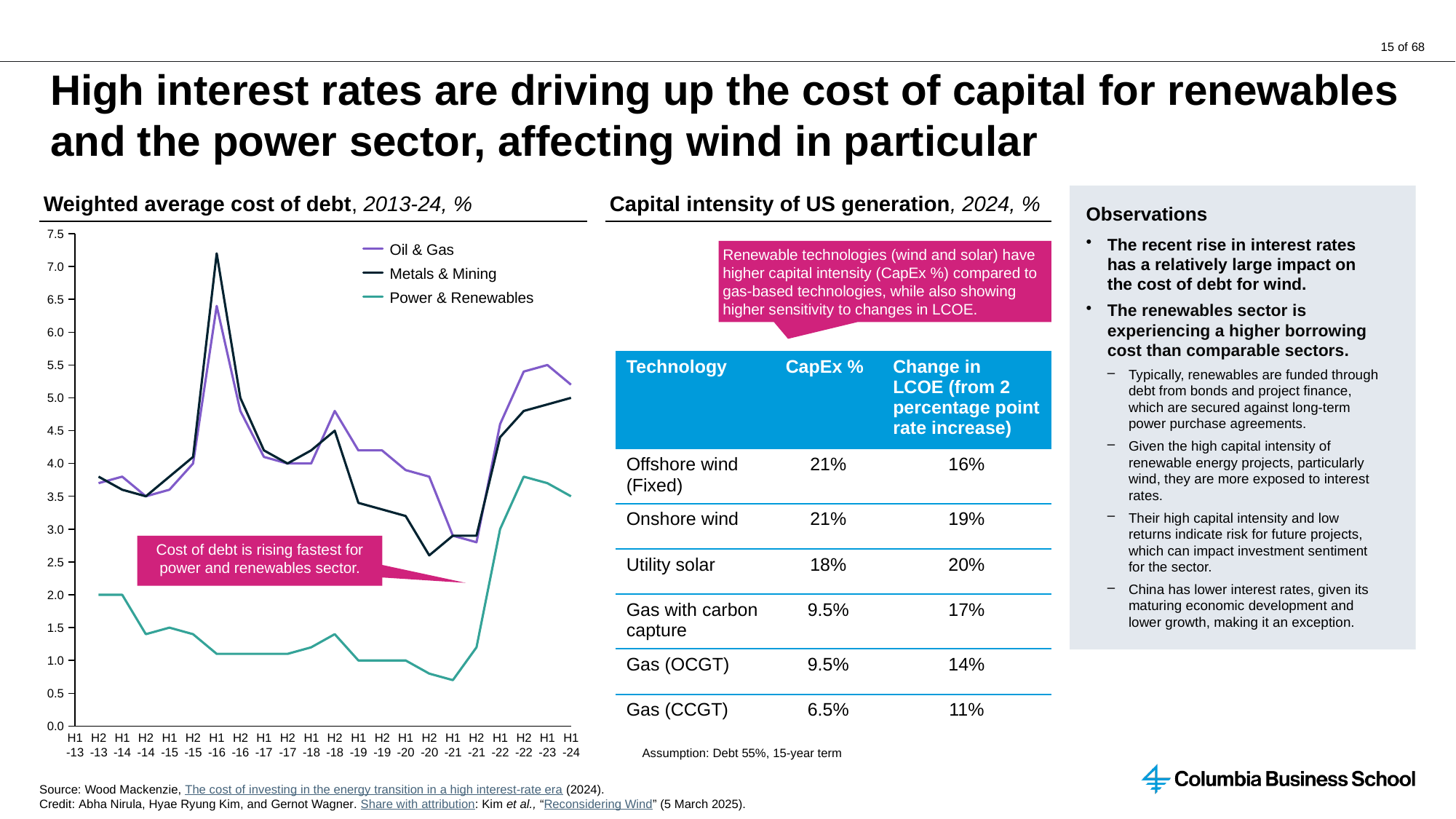
How many half-year periods are shown on the x axis of the 'Weighted average cost of debt' chart? 22 In the 'Weighted average cost of debt' chart, is the value for Power & Renewables at H2-16 greater or less than 1.5? less In the 'Weighted average cost of debt' chart, which series reaches the highest peak over the whole period? Metals & Mining What kind of chart is the 'Weighted average cost of debt' chart? Line chart In the 'Weighted average cost of debt' chart, is the value for Metals & Mining at H1-16 greater or less than 7.0? greater In the 'Weighted average cost of debt' chart, is the value for Power & Renewables at H1-21 greater or less than 1.0? less How many series does the legend of the 'Weighted average cost of debt' chart list? 3 What is the title of the line chart on the left of the slide? Weighted average cost of debt, 2013-24, % In the 'Weighted average cost of debt' chart, which series has the lowest value at H1-24? Power & Renewables In the 'Weighted average cost of debt' chart, at H1-16, which is higher: Metals & Mining or Oil & Gas? Metals & Mining In the 'Weighted average cost of debt' chart, does the Power & Renewables line rise or fall between H1-21 and H2-22? Rise